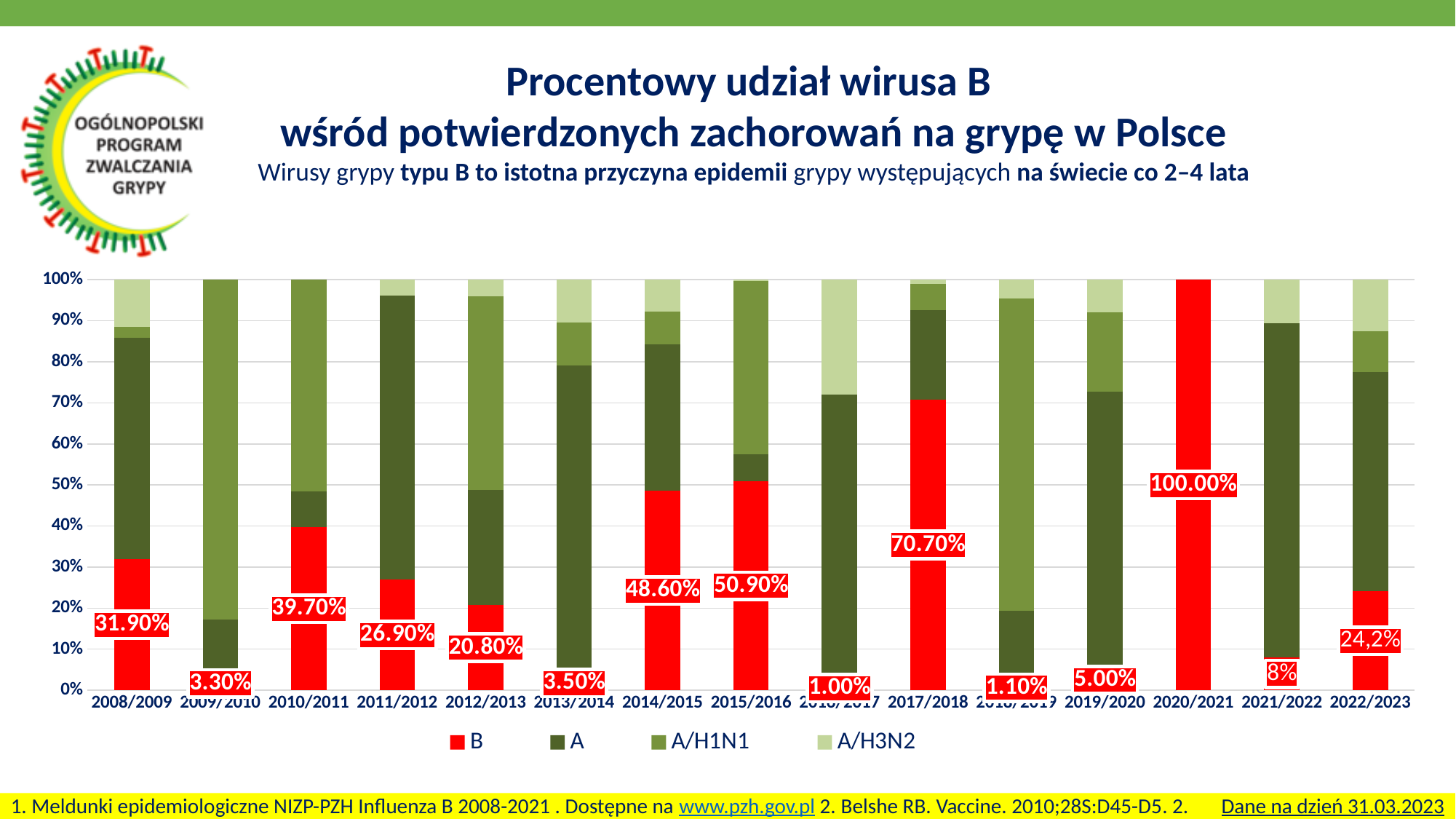
How many seasons are shown on the x axis of the chart? 15 In which season is the share of virus B the lowest? 2016/2017 How many series does the chart legend list? 4 What is the percentage share of virus B in the 2022/2023 season? 24,2% Which season has a larger share of virus B, 2010/2011 or 2011/2012? 2010/2011 What is the difference between the virus B share in 2017/2018 and in 2014/2015? 22.10% Is the A/H1N1 share in the 2018/2019 season greater or less than 50%? greater What is the percentage share of virus B in the 2012/2013 season? 20.80% Does the share of virus B rise or fall from 2018/2019 to 2020/2021? Rises In which season is the share of virus B the highest? 2020/2021 What is the percentage share of virus B in the 2017/2018 season? 70.70% What kind of chart is shown on the slide? Stacked bar chart